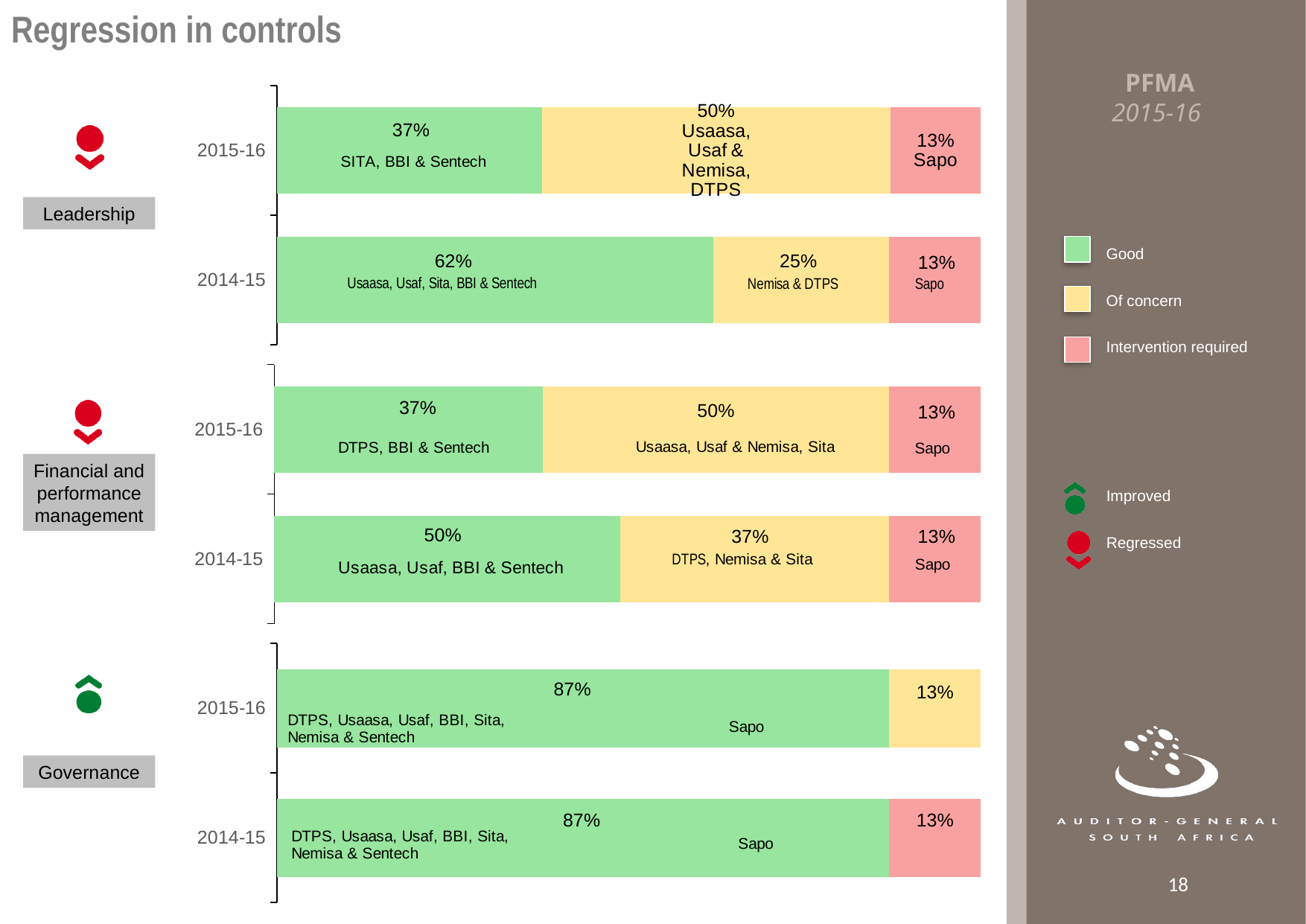
In the Governance chart, what percentage of auditees had good controls in 2015-16? 87% In the Financial and performance management chart, what percentage required intervention in 2014-15? 13% In the Leadership chart, what percentage was 'Of concern' in 2014-15? 25% In the Financial and performance management chart, which year had the larger 'Good' share, 2015-16 or 2014-15? 2014-15 How many categories does the legend list for the bar colours (Good, Of concern, Intervention required)? 3 In the Leadership chart, what percentage of auditees had good controls in 2015-16? 37% In the Governance chart, which auditee is in the 13% segment for 2014-15? Sapo In the Leadership chart, by how many percentage points did the 'Good' share fall from 2014-15 to 2015-16? 25 percentage points In the Financial and performance management chart, what percentage was 'Of concern' in 2015-16? 50% In the Leadership chart, what percentage of auditees had good controls in 2014-15? 62% Which of the three control areas is marked as improved? Governance What type of chart is used to show the control assessments on this slide? Stacked bar chart